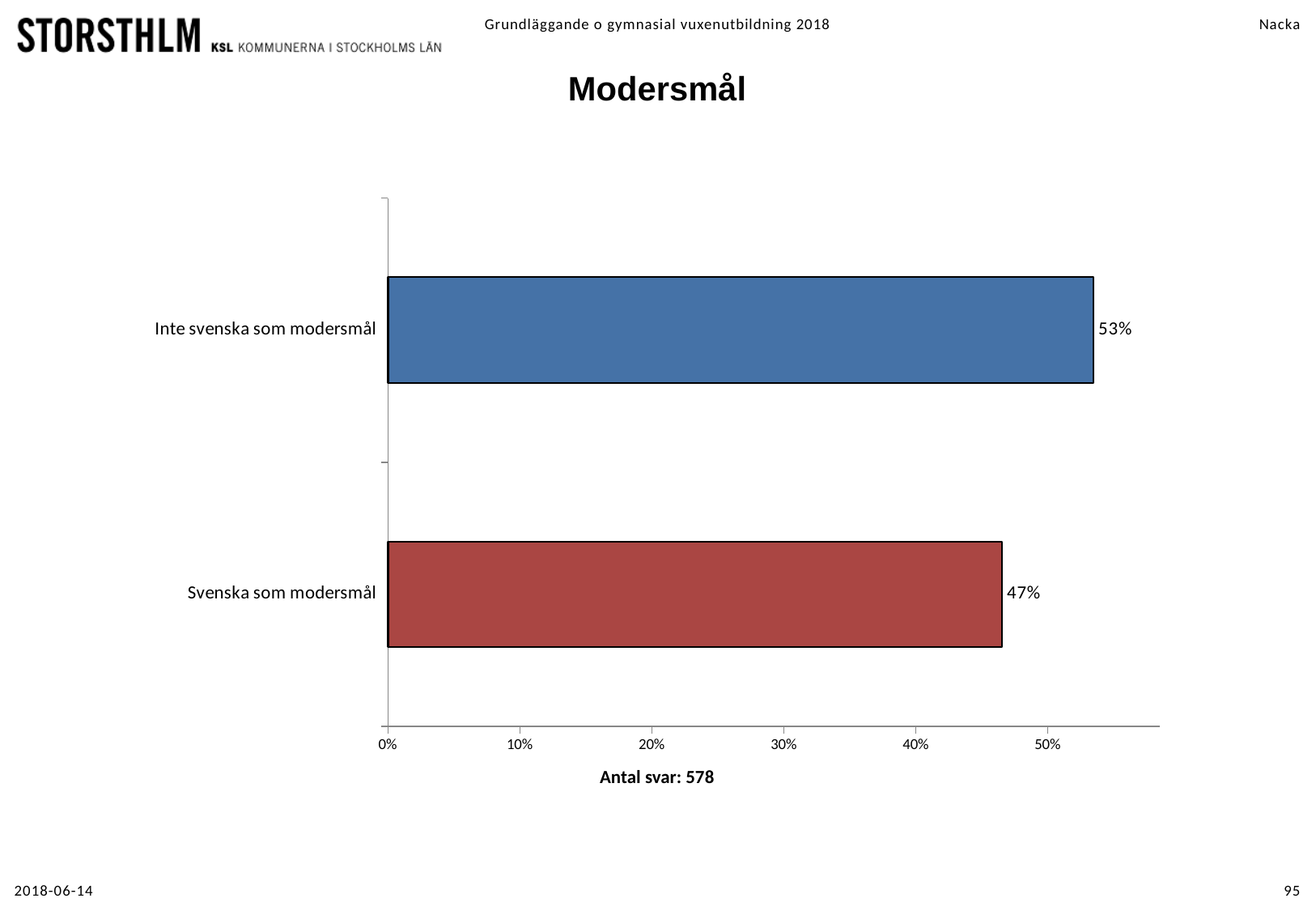
What is the difference between the values for "Inte svenska som modersmål" and "Svenska som modersmål"? 6% What is the title of the chart? Modersmål Is the value for "Svenska som modersmål" greater or less than 50%? less Which category has the lowest value? Svenska som modersmål What is the value for "Inte svenska som modersmål"? 53% What is the value for "Svenska som modersmål"? 47% How many categories are shown in the chart? 2 Which category has the highest value? Inte svenska som modersmål Is the value for "Inte svenska som modersmål" greater or less than 50%? greater What kind of chart is shown on the slide? bar chart Which is larger: the value for "Svenska som modersmål" or the value for "Inte svenska som modersmål"? Inte svenska som modersmål How many responses (Antal svar) does the chart report? 578